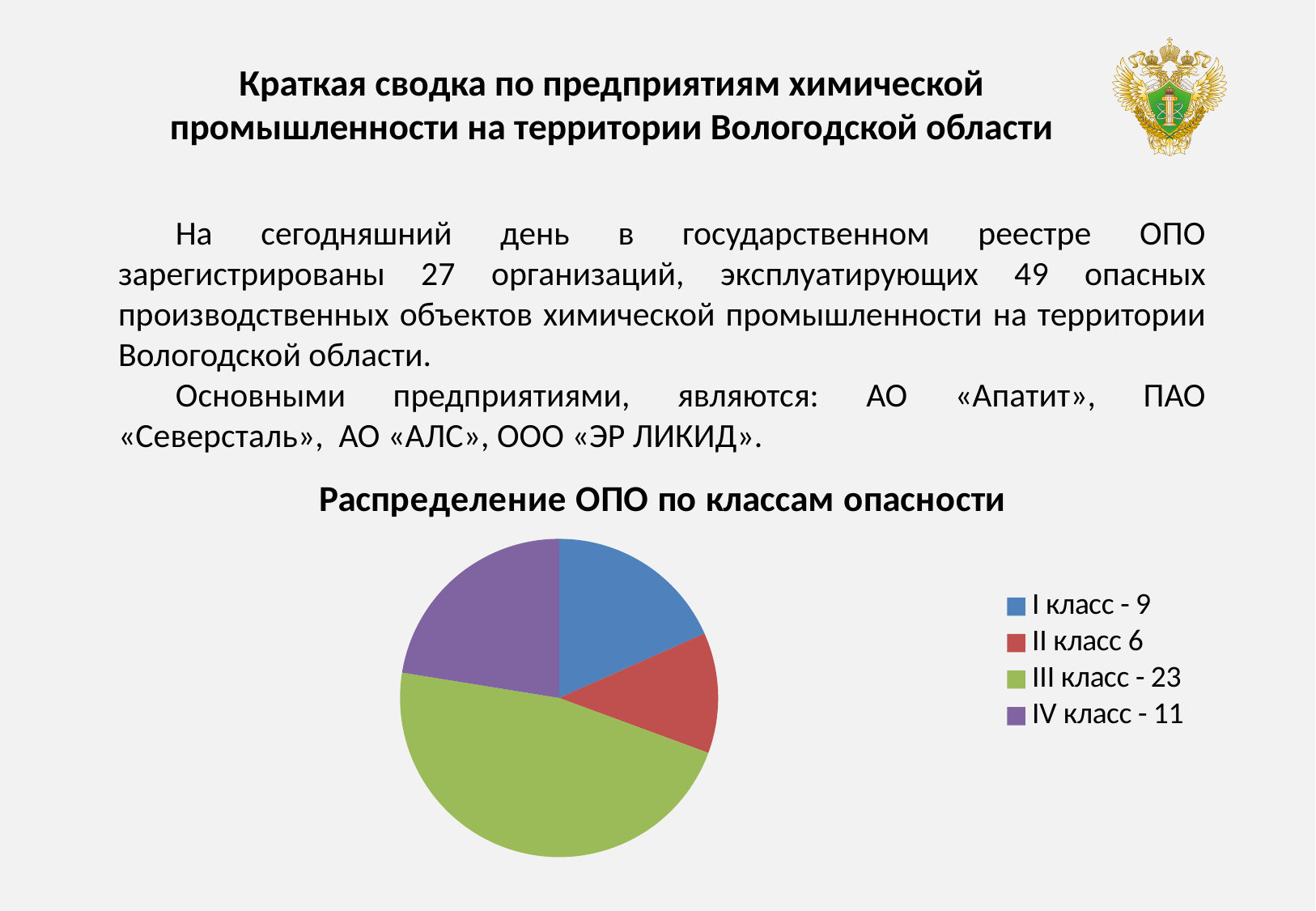
Which hazard class has the largest slice in the pie chart? III класс What kind of chart is shown under the title "Распределение ОПО по классам опасности"? pie chart According to the legend, what is the value for IV класс? 11 What colour is the slice for III класс in the pie chart? green How many slices does the pie chart "Распределение ОПО по классам опасности" have? 4 According to the legend, what is the value for III класс? 23 What is the difference between the values for III класс and IV класс? 12 According to the legend, what is the value for I класс? 9 Which hazard class has the smallest slice in the pie chart? II класс According to the legend, what is the value for II класс? 6 Which is larger, the value for I класс or the value for IV класс? IV класс How many entries does the legend of the pie chart list? 4